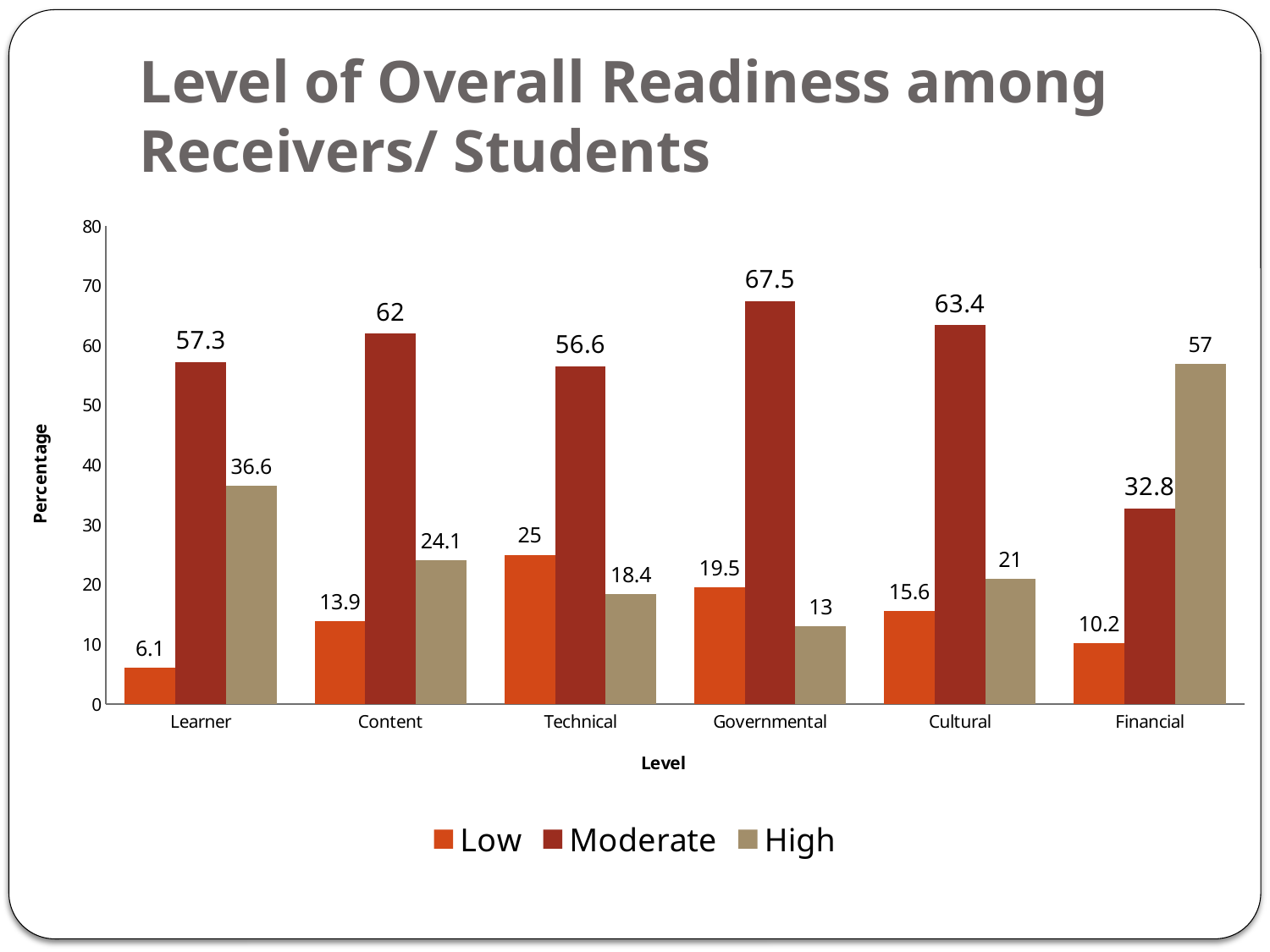
What is the Moderate value for Governmental? 67.5 What is the High value for Financial? 57 How many categories are shown on the x axis? 6 Which is larger for Financial: the Moderate value or the High value? High How many series does the legend list? 3 Which category has the lowest Low value? Learner What is the difference between the High values for Learner and Content? 12.5 What kind of chart is shown on the slide? bar chart What is the Low value for Learner? 6.1 What is the label of the y axis? Percentage Is the Low value for Technical greater or less than 20? greater Which category has the highest Moderate value? Governmental